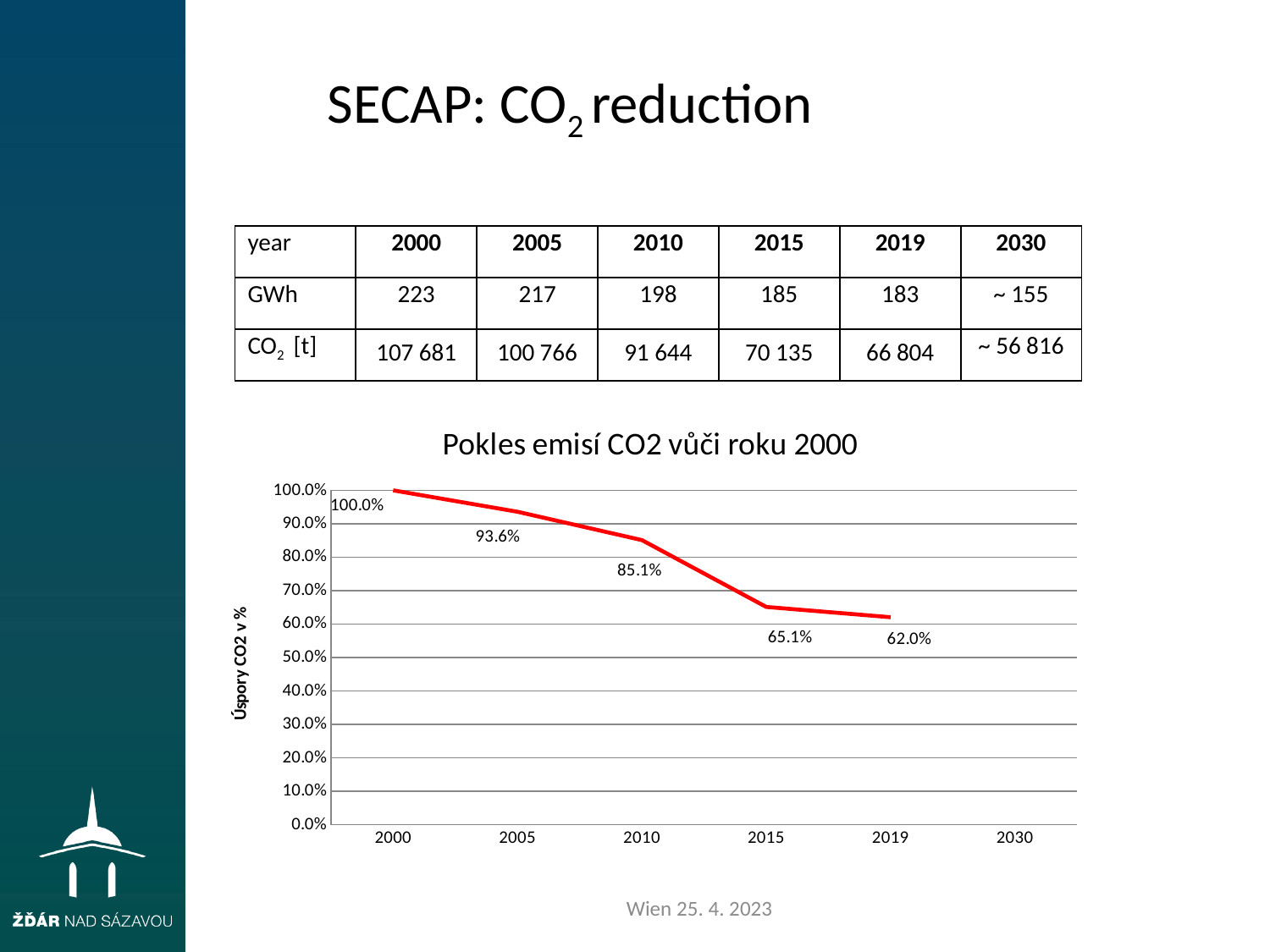
Which year has the lowest plotted value? 2019 What is the value plotted for 2015? 65.1% Which year has the highest plotted value? 2000 What is the value plotted for 2010? 85.1% What is the difference between the values for 2000 and 2019? 38.0% What kind of chart is shown on the slide? line chart What is the value plotted for 2005? 93.6% What is the difference between the values for 2010 and 2015? 20.0% Do the plotted values rise or fall from 2000 to 2019? fall What is the title of the chart? Pokles emisí CO2 vůči roku 2000 What is the value plotted for 2019? 62.0% What is the label of the vertical axis? Úspory CO2 v %